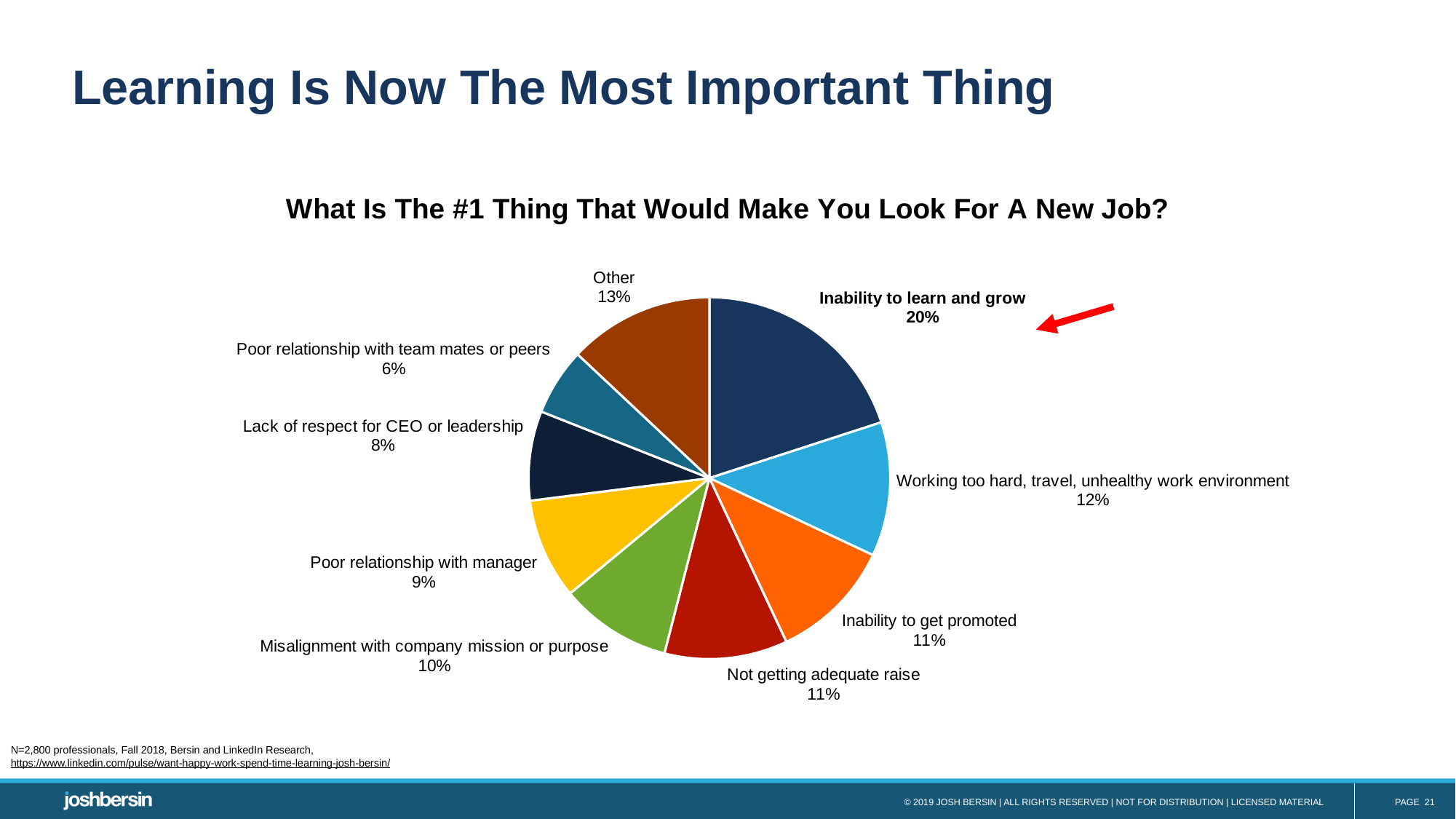
Which category has the smallest slice of the pie? Poor relationship with team mates or peers What percentage is shown for "Working too hard, travel, unhealthy work environment"? 12% What percentage is shown for "Poor relationship with manager"? 9% What is the difference in percentage points between "Inability to learn and grow" and "Other"? 7 Which is larger: "Lack of respect for CEO or leadership" or "Misalignment with company mission or purpose"? Misalignment with company mission or purpose Which category has the largest slice of the pie? Inability to learn and grow What is the title of the chart? What Is The #1 Thing That Would Make You Look For A New Job? What is the combined share of "Inability to get promoted" and "Not getting adequate raise"? 22% What kind of chart is shown on the slide? pie chart How many slices does the pie chart have? 9 What percentage is shown for "Other"? 13% What share of respondents chose "Inability to learn and grow"? 20%